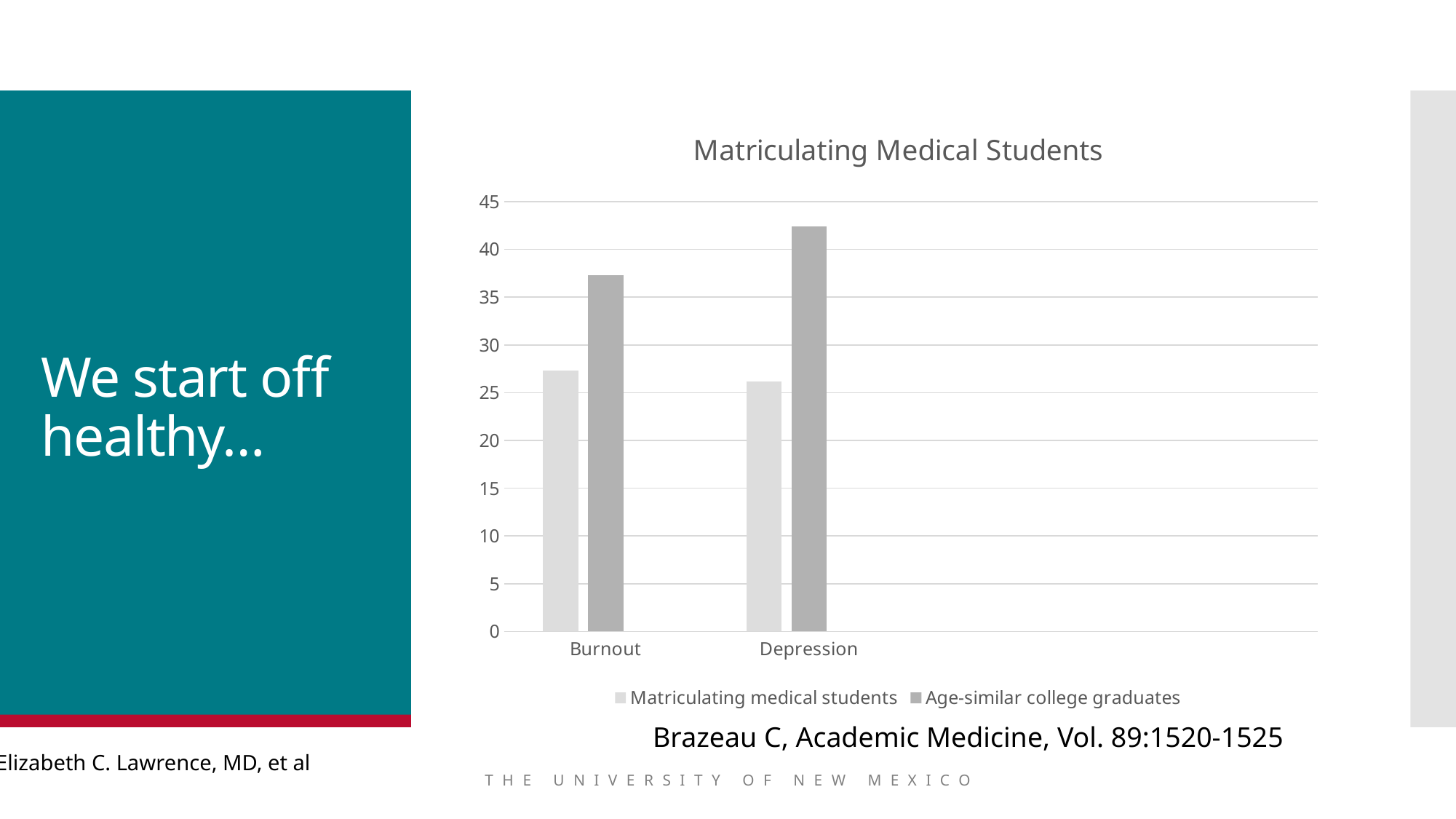
Is the value for Age-similar college graduates in the Burnout category greater or less than 35? greater Is the value for Matriculating medical students in the Burnout category greater or less than 25? greater What is the title of the chart? Matriculating Medical Students How many categories are shown on the x axis of the chart? 2 In the Depression category, which series has the higher value? Age-similar college graduates Is the value for Age-similar college graduates in the Depression category greater or less than 40? greater For Age-similar college graduates, which category has the larger value, Burnout or Depression? Depression Which series is shown in the darker grey bars? Age-similar college graduates How many series does the chart legend list? 2 What type of chart is shown on the slide? bar chart